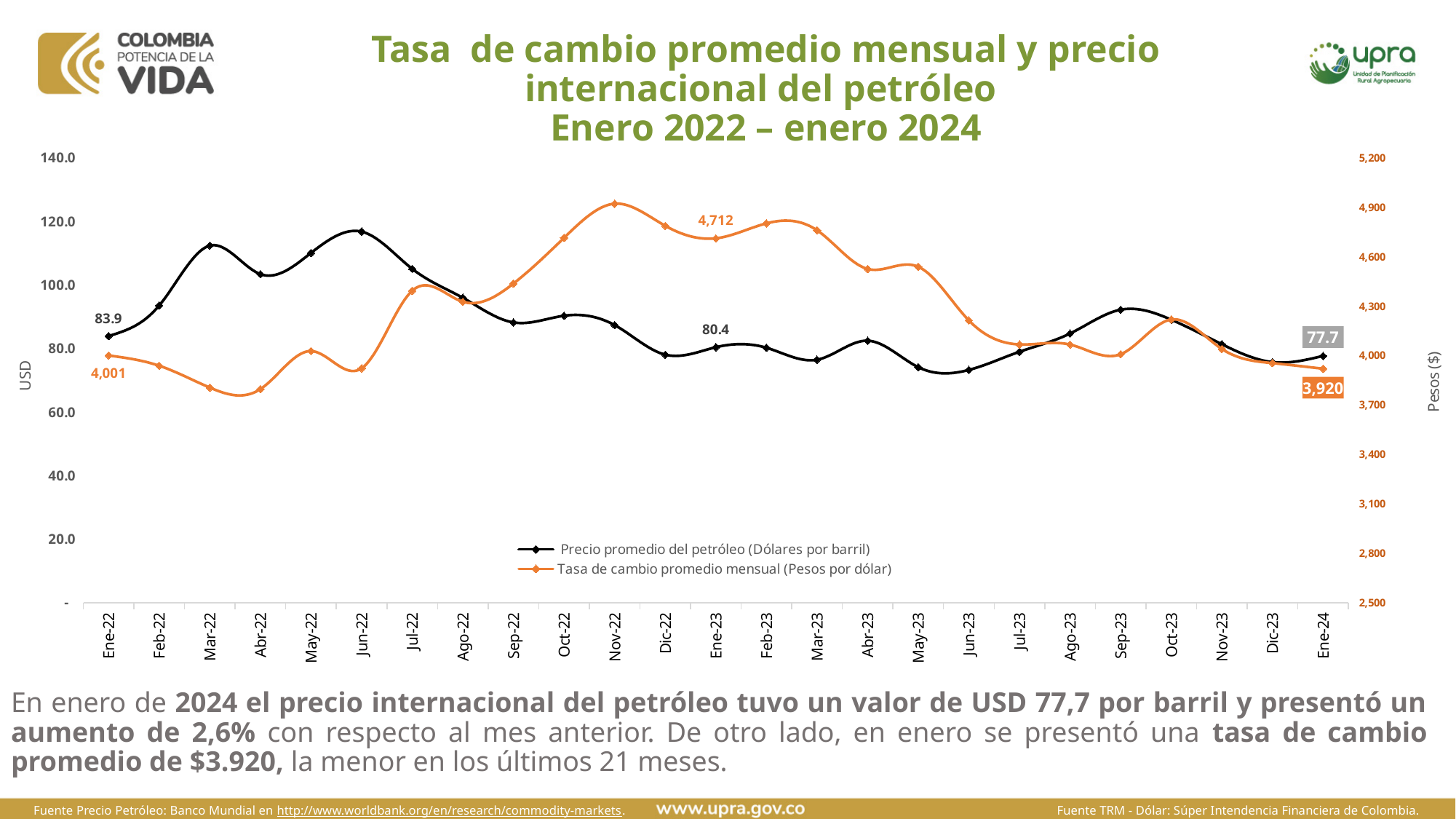
Is the Precio promedio del petróleo for Jun-22 greater or less than 100.0? greater What kind of chart is shown on the slide? Line chart How many months are plotted along the x axis? 25 What is the value of Tasa de cambio promedio mensual (Pesos por dólar) for Ene-23? 4,712 What is the value of Precio promedio del petróleo (Dólares por barril) for Ene-22? 83.9 Which month has the higher Precio promedio del petróleo, Ene-22 or Ene-23? Ene-22 What is the value of Precio promedio del petróleo (Dólares por barril) for Ene-24? 77.7 How many series does the legend list? 2 What is the difference between the Tasa de cambio promedio mensual for Ene-23 and Ene-24? 792 In which month does the Tasa de cambio promedio mensual reach its highest value? Nov-22 What is the value of Tasa de cambio promedio mensual (Pesos por dólar) for Ene-24? 3,920 By how much did the Precio promedio del petróleo fall from Ene-22 to Ene-24? 6.2